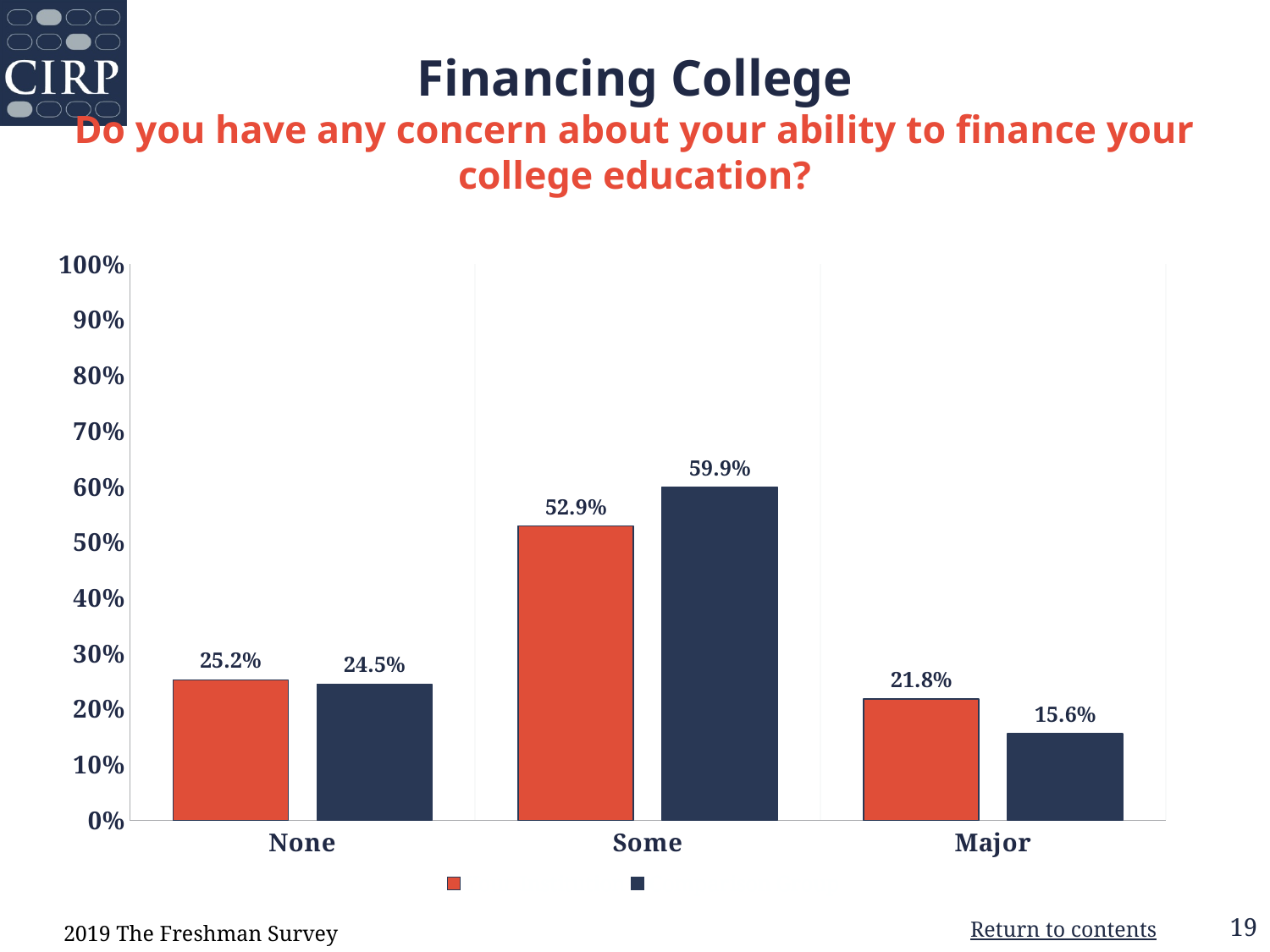
What is the value of the dark blue bar for the "None" category? 24.5% Is the value of the dark blue bar for "Some" greater or less than 50%? greater What is the value of the orange bar for the "Some" category? 52.9% Which category has the lowest value among the dark blue bars? Major For the "Some" category, which bar is larger, the orange bar or the dark blue bar? the dark blue bar Which category has the highest value among the orange bars? Some What is the value of the dark blue bar for the "Major" category? 15.6% How many series does the legend list? 2 What kind of chart is shown on the slide? bar chart How many categories are shown on the x axis? 3 What is the difference between the dark blue bar and the orange bar for the "Some" category? 7.0% What is the difference between the orange bar and the dark blue bar for the "Major" category? 6.2%